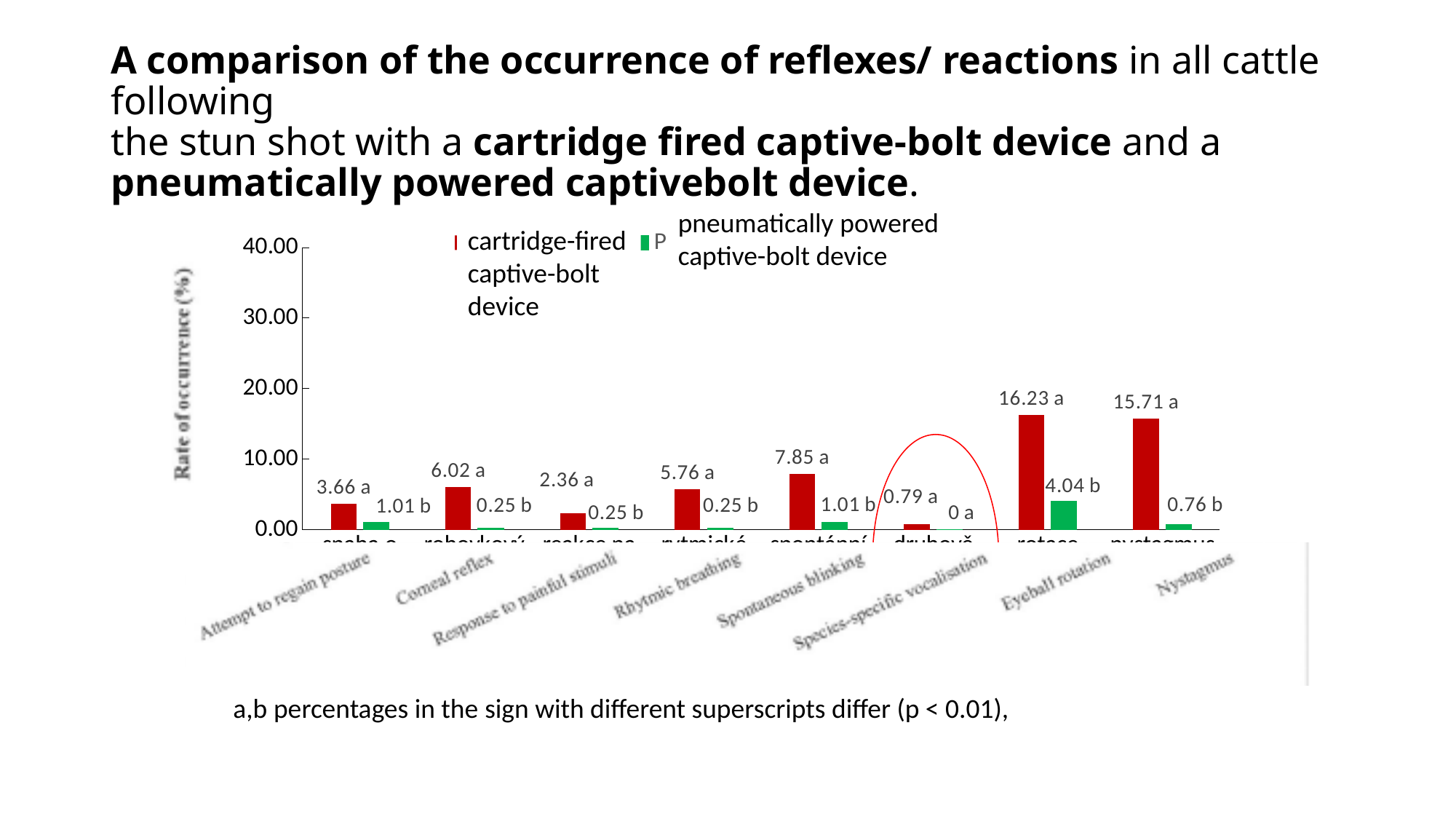
How many reflex/reaction categories are shown on the x axis? 8 What is the rate of occurrence for the cartridge-fired captive-bolt device for Spontaneous blinking? 7.85 a What is the difference between the cartridge-fired and pneumatically powered values for Nystagmus? 14.95 What is the rate of occurrence for the pneumatically powered captive-bolt device for Eyeball rotation? 4.04 b Is the cartridge-fired captive-bolt device value for Eyeball rotation greater or less than 10.00? greater What is the rate of occurrence for the cartridge-fired captive-bolt device for Eyeball rotation? 16.23 a Which category has the lowest rate of occurrence for the cartridge-fired captive-bolt device? Species-specific vocalisation Which category has the highest rate of occurrence for the cartridge-fired captive-bolt device? Eyeball rotation Which is larger for the cartridge-fired captive-bolt device: Corneal reflex or Rhytmic breathing? Corneal reflex What kind of chart is shown on the slide? bar chart What is the rate of occurrence for the pneumatically powered captive-bolt device for Species-specific vocalisation? 0 a How many series does the legend list? 2